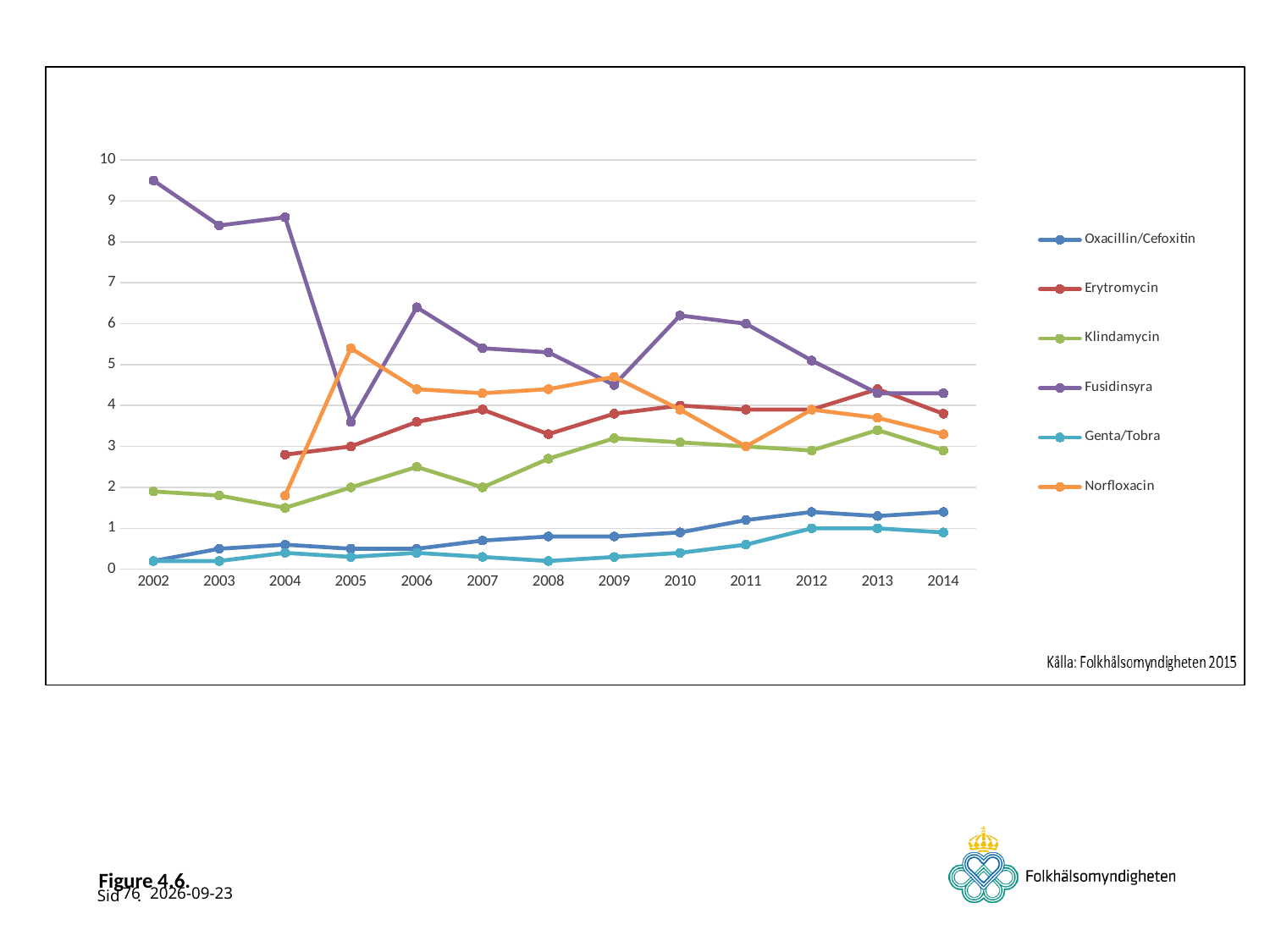
How many years are shown on the x axis? 13 Is the value for Norfloxacin in 2005 greater or less than 5? greater Which series has the highest value in 2010? Fusidinsyra What kind of chart is shown on the slide? line chart Is the value for Fusidinsyra in 2002 greater or less than 9? greater Which is larger: Norfloxacin in 2005 or Erytromycin in 2005? Norfloxacin in 2005 Which series has the highest value in 2002? Fusidinsyra Is the value for Fusidinsyra in 2005 greater or less than 4? less Does the Fusidinsyra line rise or fall from 2002 to 2005? fall What source is cited on the slide? Källa: Folkhälsomyndigheten 2015 Which series has the lowest value in 2014? Genta/Tobra How many series does the legend list? 6